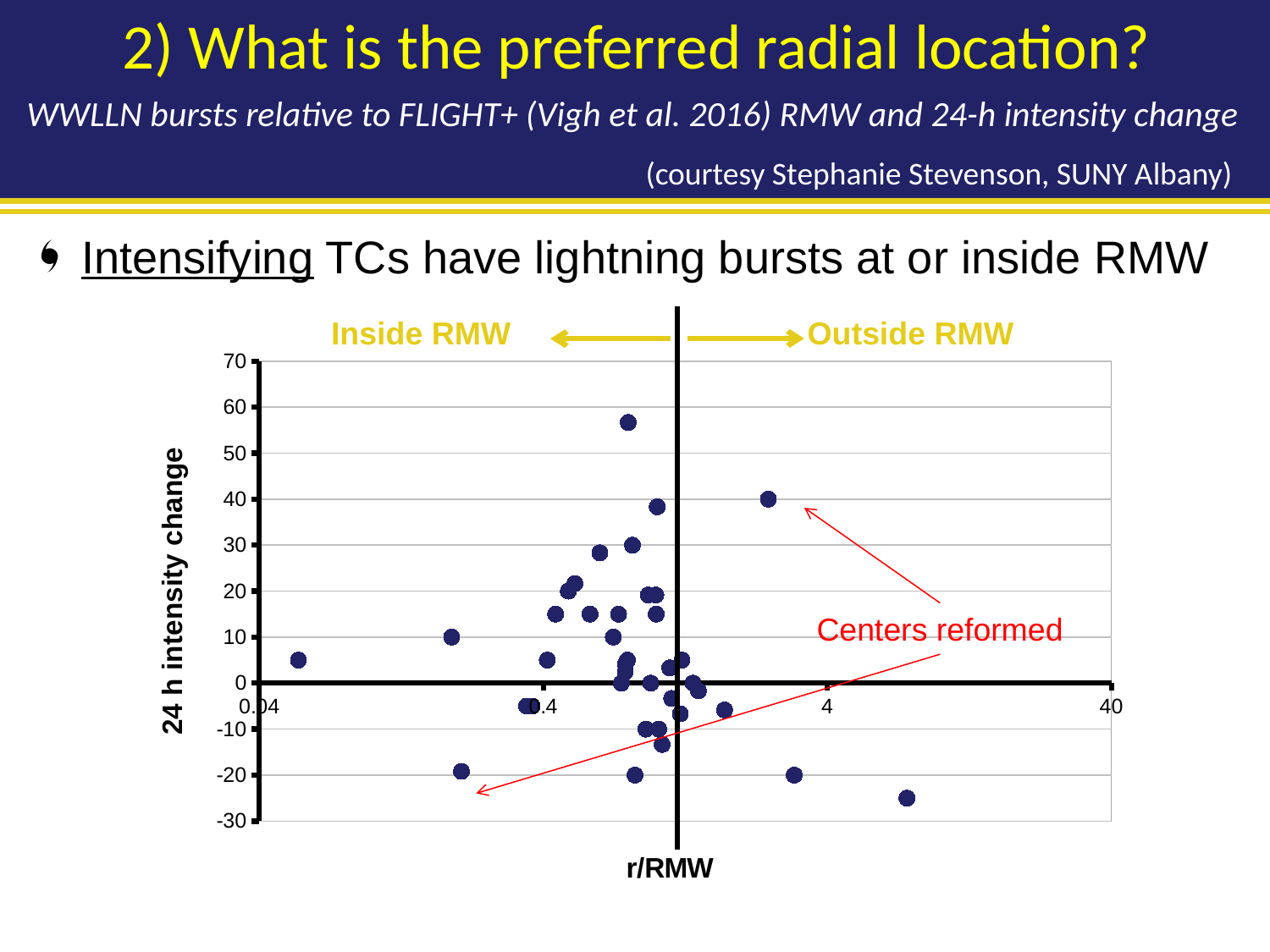
Is the 24 h intensity change of the point with the largest r/RMW value greater or less than 0? less Is the 24 h intensity change of the leftmost point (smallest r/RMW) greater or less than 0? greater How many points on the chart have a 24 h intensity change above 50? 1 Is the 24 h intensity change of the highest point on the Outside RMW side greater or less than 30? greater What is the label of the x axis of the chart? r/RMW What kind of chart is shown on the slide? scatter plot On which side of the vertical RMW line does the point with the highest 24 h intensity change lie, Inside RMW or Outside RMW? Inside RMW What is the label of the y axis of the chart? 24 h intensity change